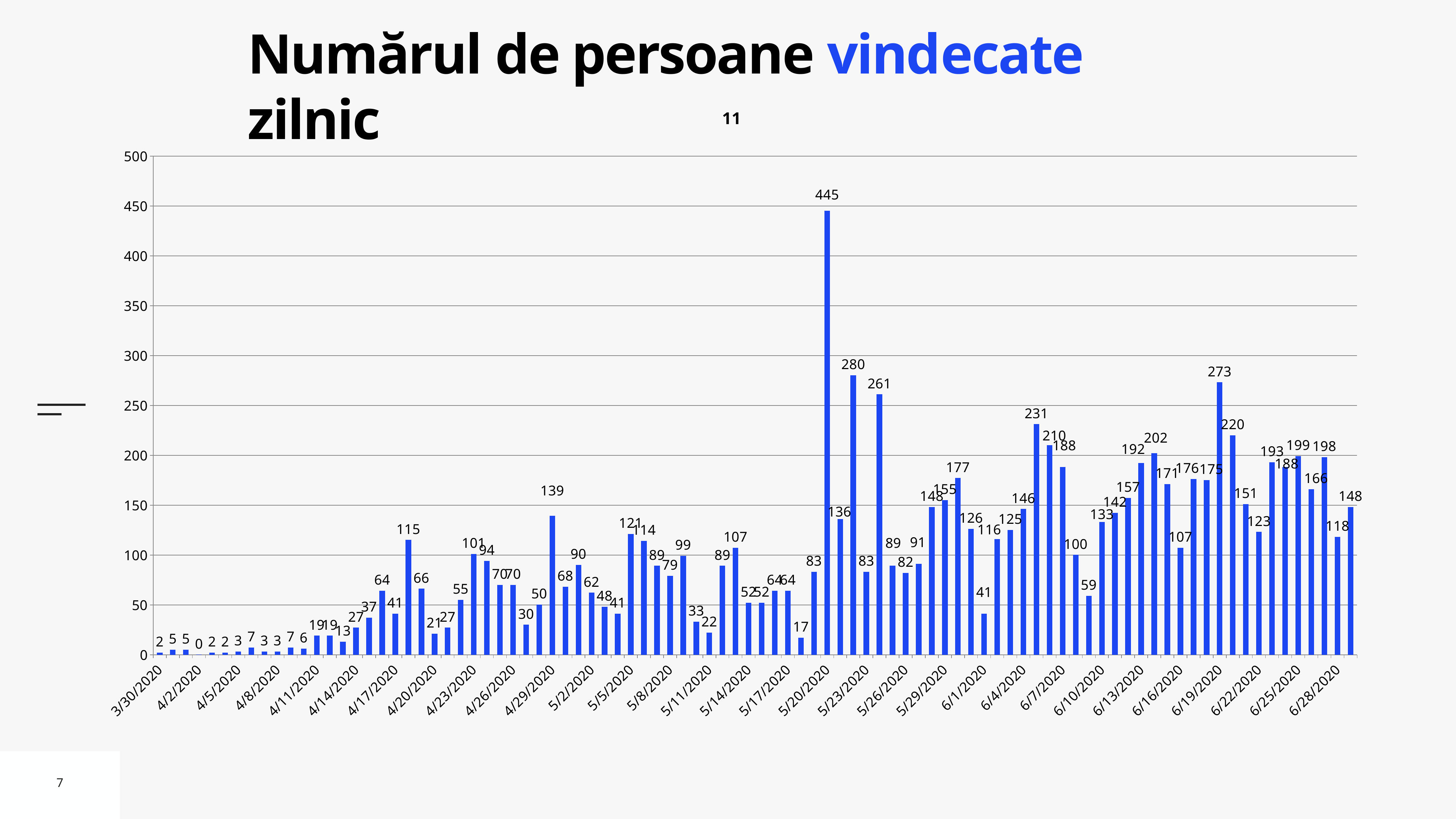
What is the value for 6/28/2020? 118 What is the value for 6/19/2020? 273 Is the value for 5/5/2020 greater or less than 100? greater Which is larger, the value for 6/13/2020 or the value for 6/7/2020? 6/13/2020 On which date is the highest value recorded? 5/20/2020 Overall, do the values rise or fall from 3/30/2020 to the end of June? rise What is the title of the chart on the slide? 11 What is the value for 4/29/2020? 139 What is the difference between the values for 5/20/2020 and 6/19/2020? 172 What is the value for 4/2/2020? 0 What is the highest value shown in the chart? 445 What type of chart is shown on the slide? bar chart